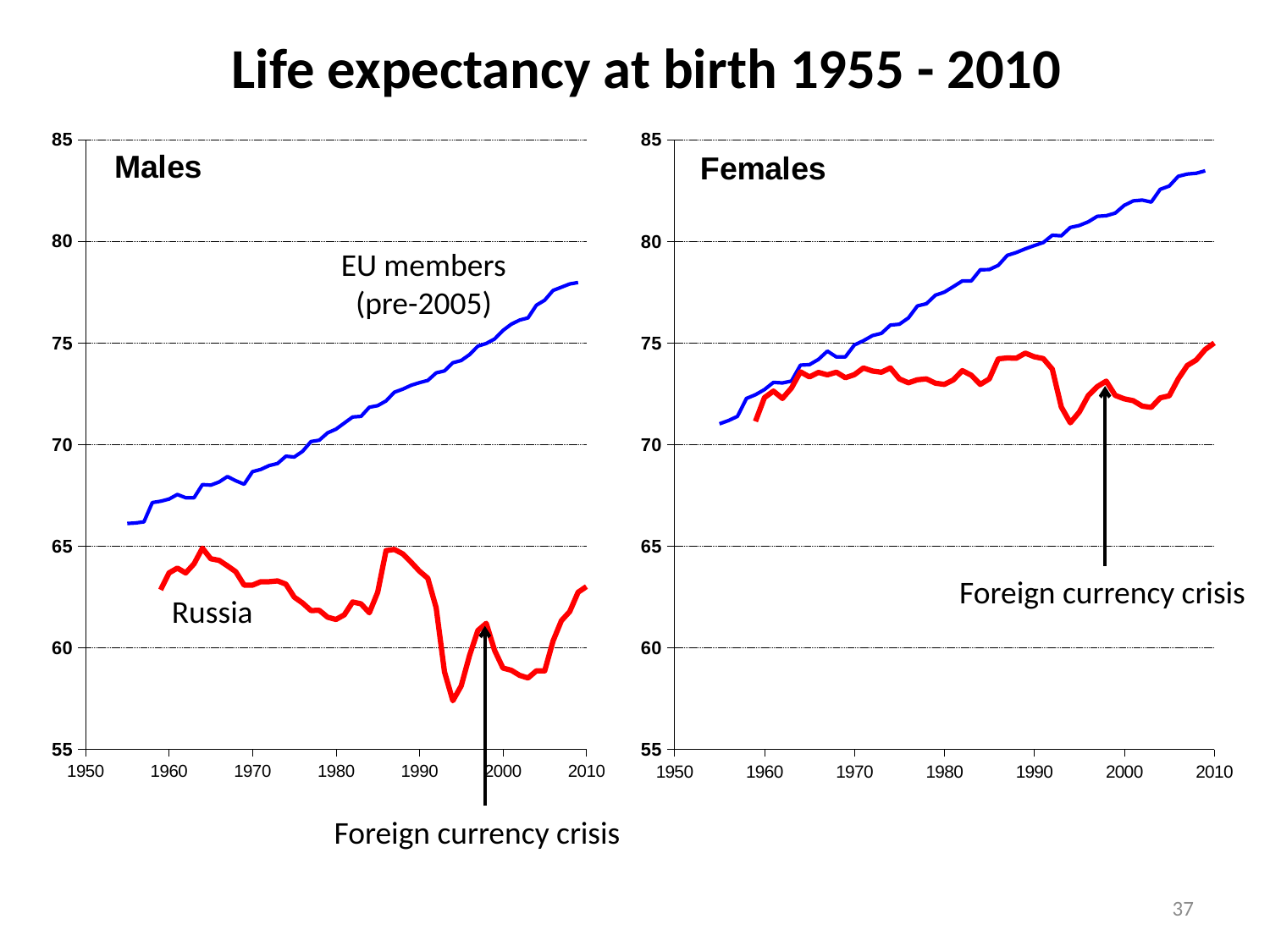
In the Females chart, is the value for Russia in 1960 greater or less than 70? greater What event do the arrows on both charts point to? Foreign currency crisis What colour is the Russia line in the charts? red In the Females chart, which series is higher in 2005, EU members (pre-2005) or Russia? EU members (pre-2005) In the Females chart, is the value for Russia around 1994 greater or less than 75? less In the Males chart, which series is higher in 2000, EU members (pre-2005) or Russia? EU members (pre-2005) In the Females chart, is the value for EU members (pre-2005) in 2010 greater or less than 80? greater How many series are plotted in the Males chart? 2 In the Males chart, does the EU members (pre-2005) line rise or fall from 1955 to 2010? rises What kind of chart is the Males chart? line chart